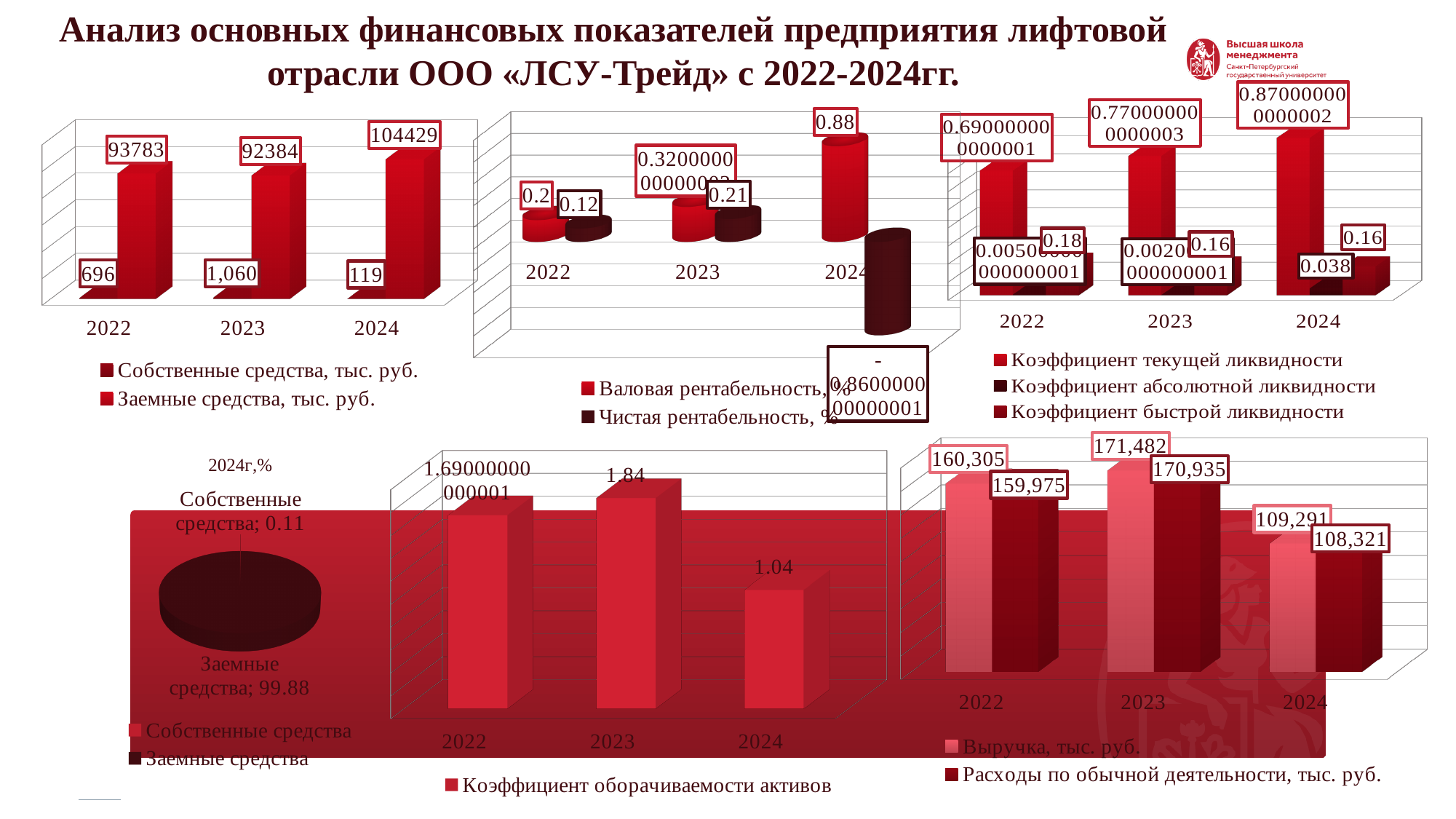
In the top-right chart (liquidity coefficients), what is the value of Коэффициент быстрой ликвидности for 2022? 0.18 In the bottom-middle chart (Коэффициент оборачиваемости активов), which year has the lowest value? 2024 In the top-left chart (Собственные средства / Заемные средства), which year has the lowest value of Собственные средства, тыс. руб.? 2024 In the bottom-right chart (Выручка / Расходы), what is the difference between Выручка and Расходы по обычной деятельности for 2024? 970 In the bottom-middle chart (Коэффициент оборачиваемости активов), what is the value for 2023? 1.84 In the bottom-right chart (Выручка / Расходы), what is the value of Выручка, тыс. руб. for 2023? 171,482 In the top-left chart (Собственные средства / Заемные средства), what is the value of Заемные средства, тыс. руб. for 2024? 104429 In the bottom-left pie chart (2024г,%), what share is shown for Заемные средства? 99.88 In the top-middle chart (Валовая / Чистая рентабельность), what is the value of Валовая рентабельность, % for 2024? 0.88 In the top-middle chart (Валовая / Чистая рентабельность), what is the value of Чистая рентабельность, % for 2022? 0.12 In the top-left chart (Собственные средства / Заемные средства), what is the value of Собственные средства, тыс. руб. for 2023? 1,060 In the top-right chart (liquidity coefficients), how many series does the legend list? 3